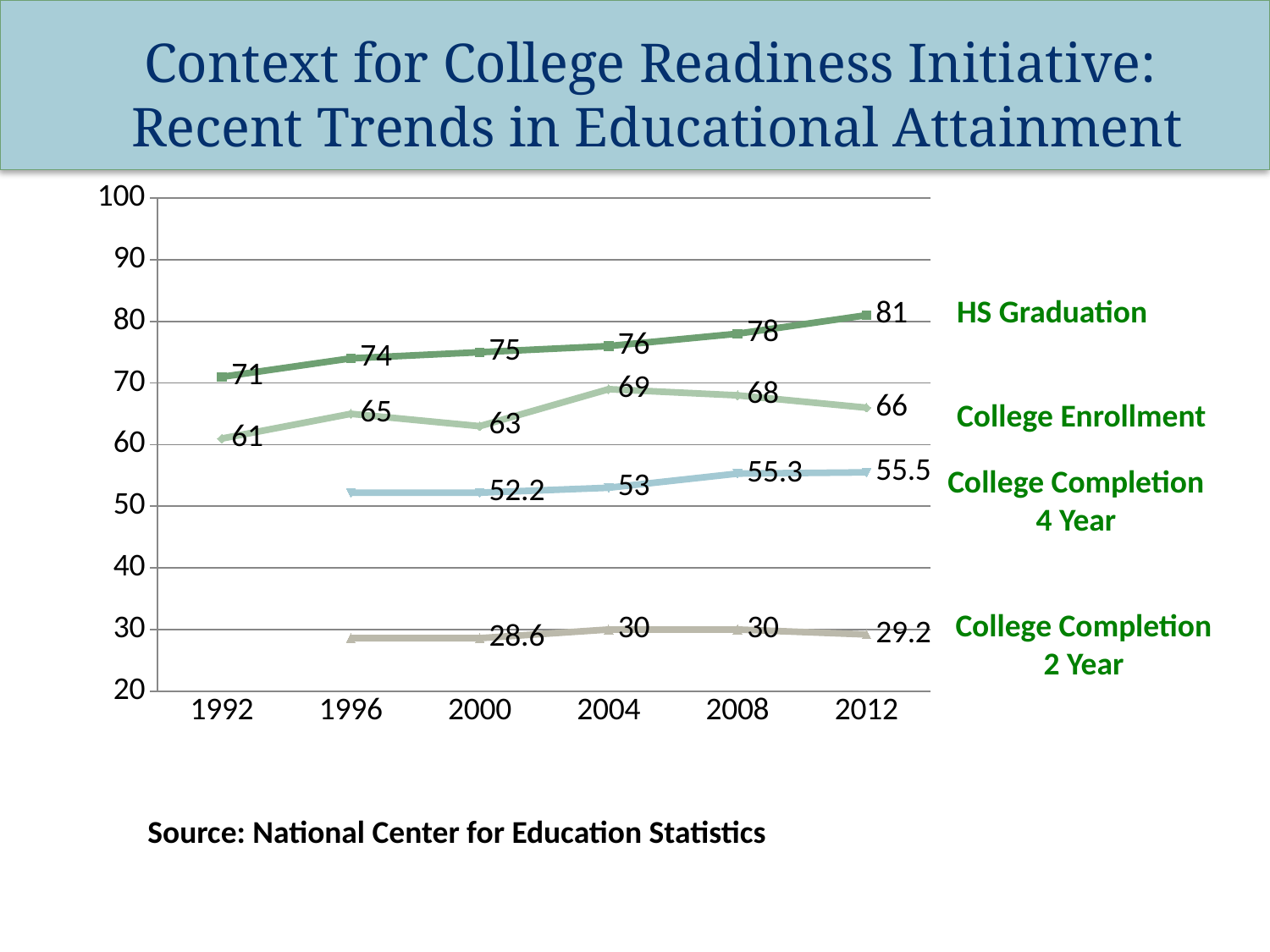
What kind of chart is shown on the slide? Line chart Does HS Graduation rise or fall from 1992 to 2012? Rise What is the HS Graduation value in 2012? 81 What is the College Completion 4 Year value in 2008? 55.3 How many series are plotted on the chart? 4 Which is larger in 2008: College Enrollment or College Completion 4 Year? College Enrollment How many years are shown on the x axis? 6 In which year is HS Graduation lowest? 1992 What is the difference between HS Graduation in 2012 and in 1992? 10 In which year is College Enrollment highest? 2004 What is the College Enrollment value in 2000? 63